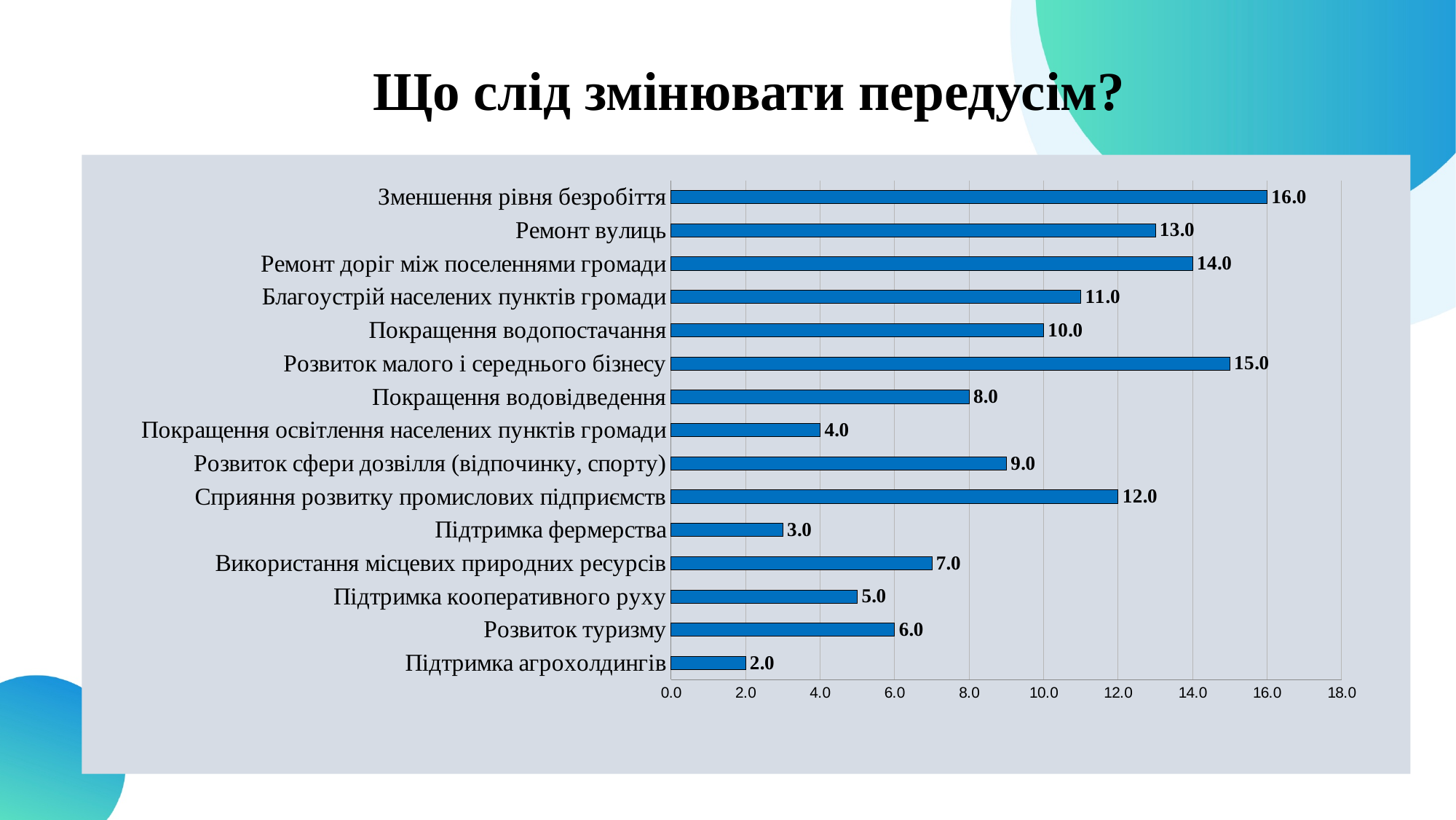
How many categories are shown in the chart? 15 What is the difference between the values for Ремонт доріг між поселеннями громади and Ремонт вулиць? 1.0 What kind of chart is shown on the slide? bar chart What is the title of the slide? Що слід змінювати передусім? Which category has the highest value? Зменшення рівня безробіття What is the value for Підтримка фермерства? 3.0 Which category has the lowest value? Підтримка агрохолдингів Is the value for Покращення водовідведення greater or less than 10.0? less What is the maximum value shown on the x axis? 18.0 What is the value for Розвиток туризму? 6.0 Which is larger: the value for Розвиток малого і середнього бізнесу or the value for Сприяння розвитку промислових підприємств? Розвиток малого і середнього бізнесу What is the value for Зменшення рівня безробіття? 16.0